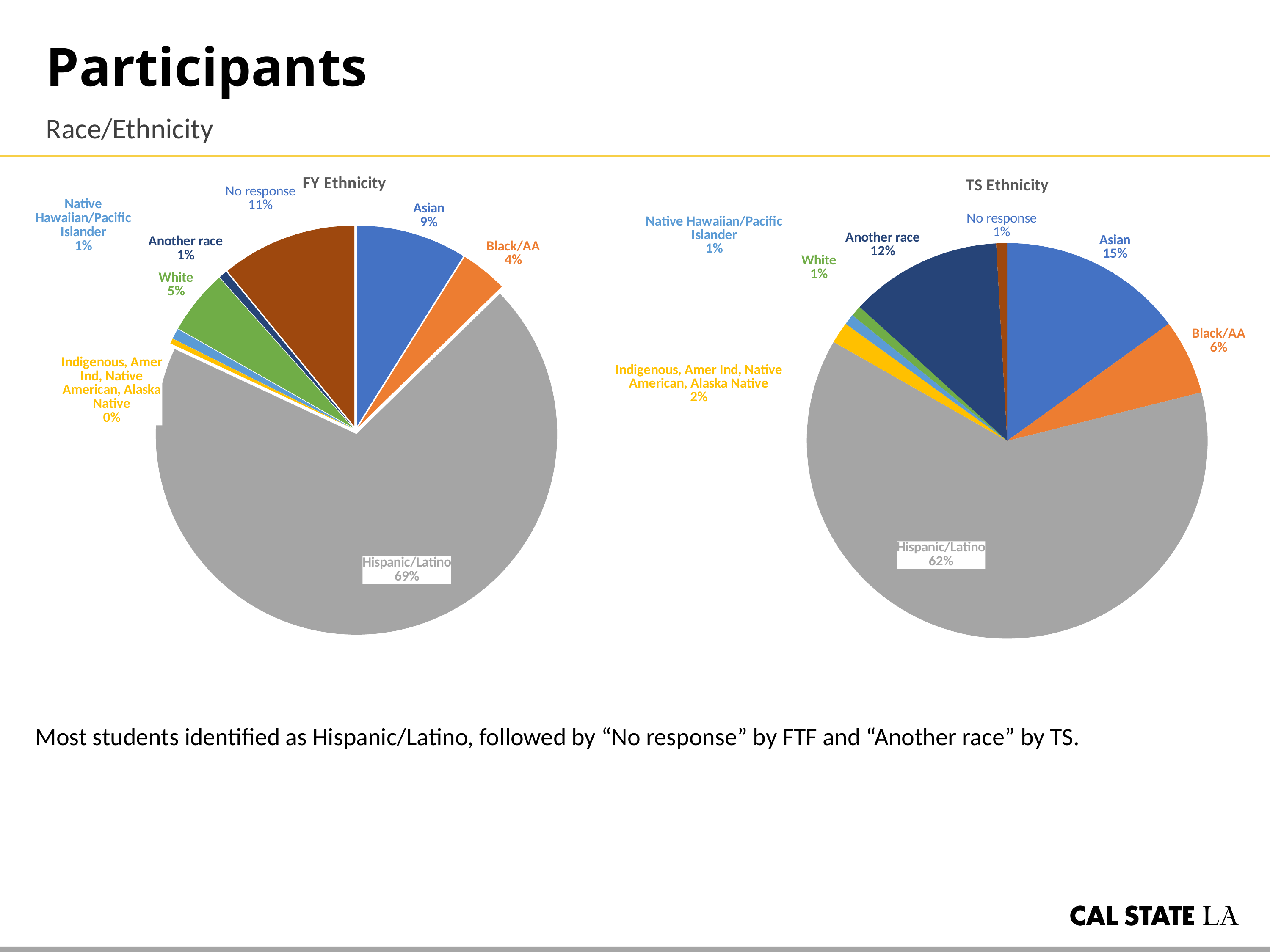
What is the difference between the Hispanic/Latino share in the FY Ethnicity chart and in the TS Ethnicity chart? 7% In the TS Ethnicity chart, which category has the largest slice? Hispanic/Latino In the TS Ethnicity chart, what percentage of participants identified as Asian? 15% What type of chart is the TS Ethnicity chart? Pie chart In the TS Ethnicity chart, which is larger: the Asian share or the Black/AA share? Asian How many categories are shown in the FY Ethnicity chart? 8 In the FY Ethnicity chart, which category has the largest slice? Hispanic/Latino In the FY Ethnicity chart, what is the share for No response? 11% In the FY Ethnicity chart, what percentage of participants identified as Hispanic/Latino? 69% In the TS Ethnicity chart, what is the share for Another race? 12% In the FY Ethnicity chart, which category has the smallest share? Indigenous, Amer Ind, Native American, Alaska Native What is the title of the chart on the left side of the slide? FY Ethnicity